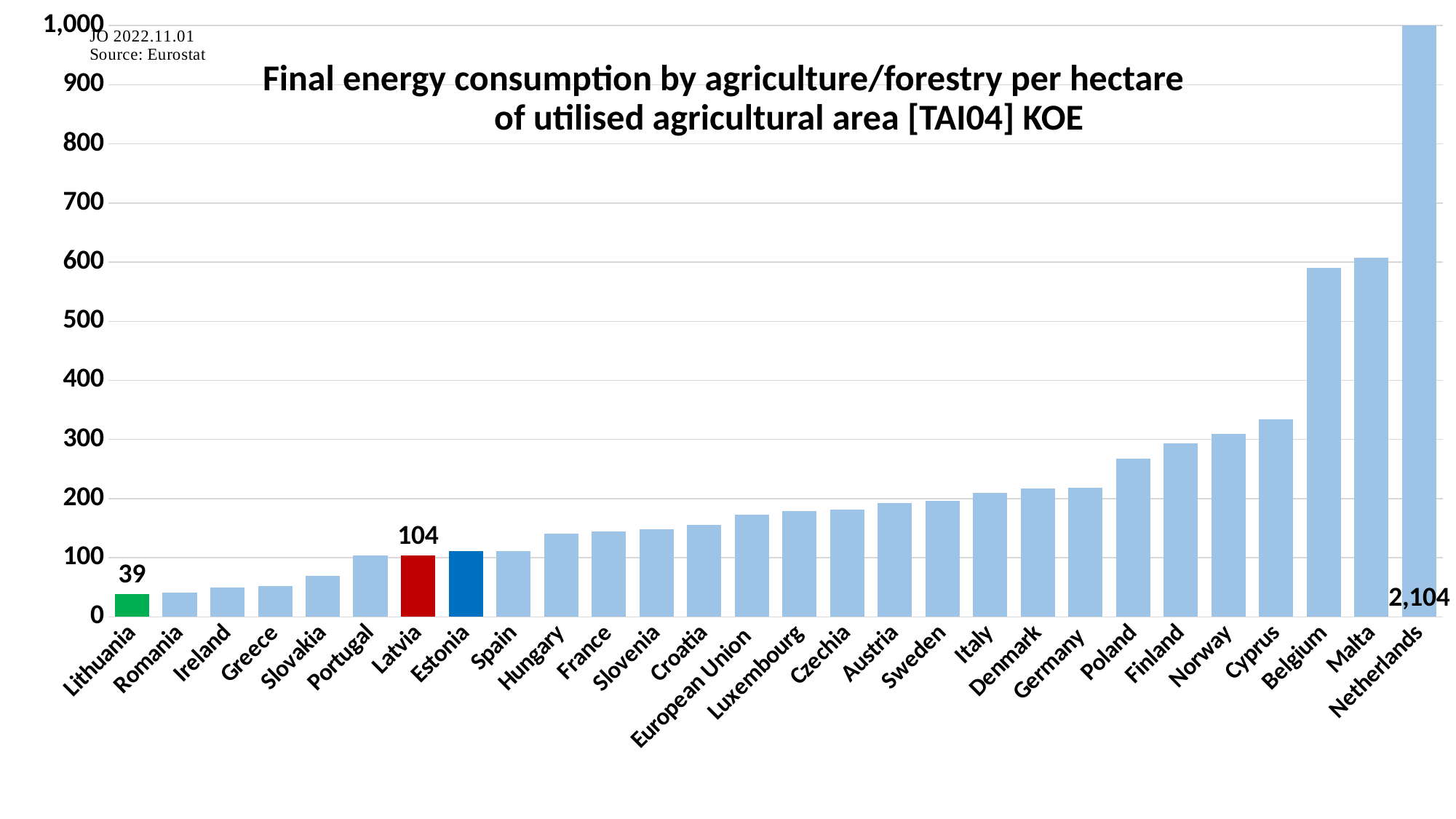
What is the value for Lithuania? 39 Is the value for Poland greater or less than 300? less What is the value for Latvia? 104 Which country has the lowest value? Lithuania Which country has the highest value? Netherlands Which is larger, the value for Belgium or the value for Cyprus? Belgium What is the value for the Netherlands? 2,104 Is the value for Belgium greater or less than 500? greater What is the difference between the values for Latvia and Lithuania? 65 What colour is the bar for Latvia? red How many countries/regions are shown on the x axis? 28 What kind of chart is this? bar chart